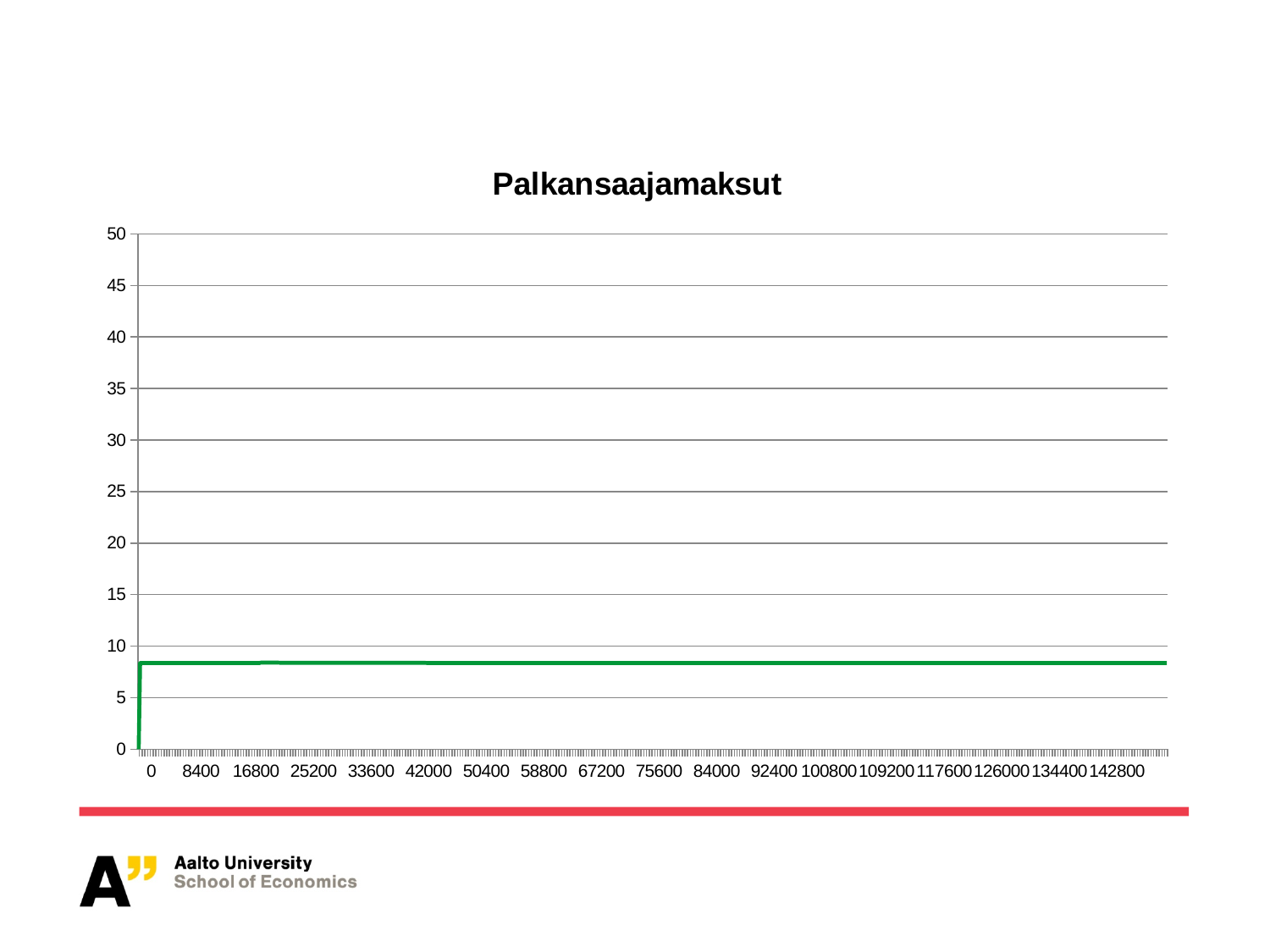
Is the value for 84000 greater or less than 10? less What is the title of the chart? Palkansaajamaksut Does the line rise, fall, or stay flat from 8400 to 142800? stays flat What kind of chart is shown on the slide? line chart What is the value of the line at x = 0? 0 Is the value for 142800 greater or less than 10? less Which has the larger value, x = 0 or x = 84000? 84000 What colour is the line plotted in the chart? green Is the value for 84000 greater or less than 5? greater Does the line rise or fall between x = 0 and x = 8400? rise